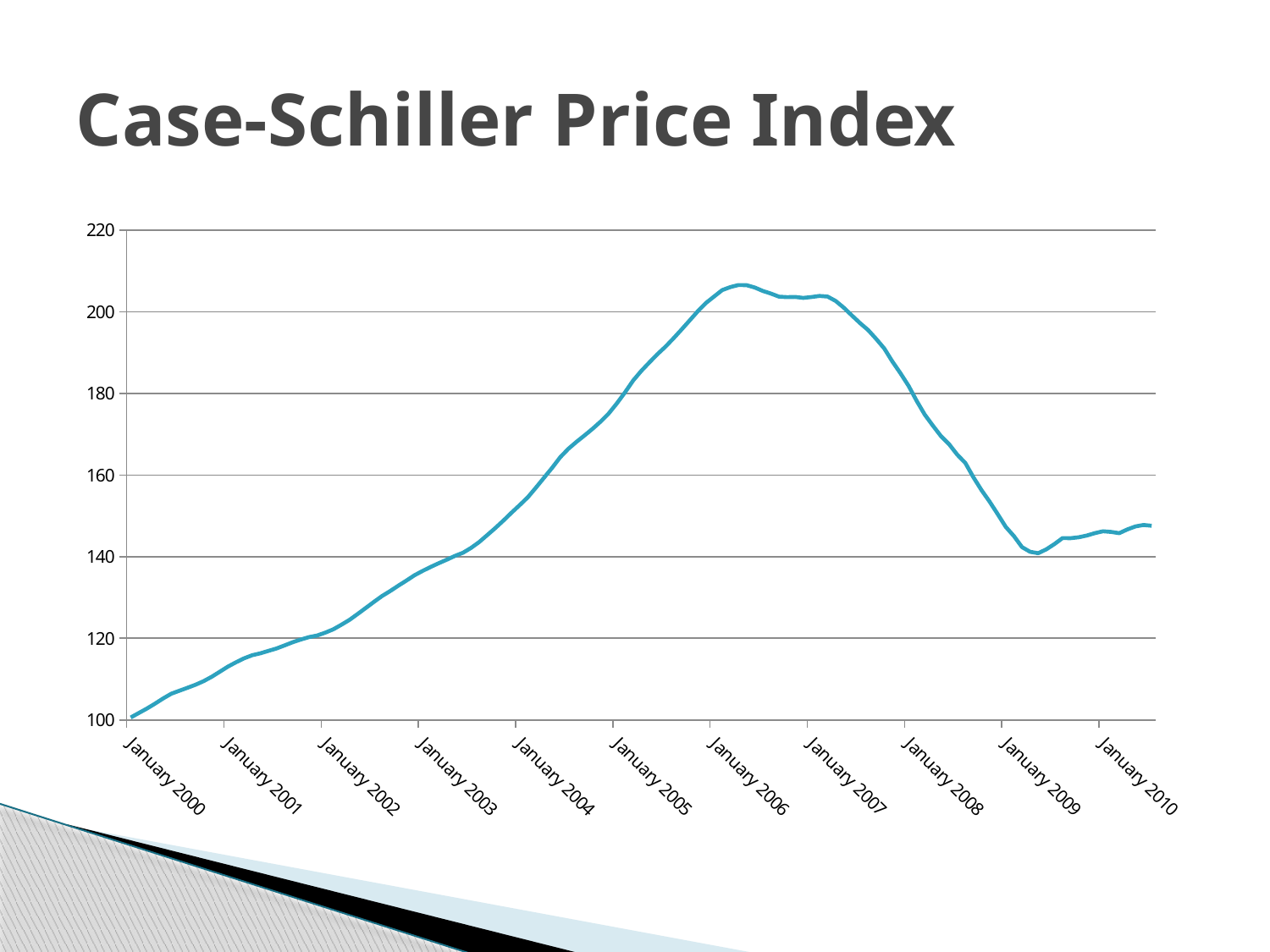
Is the value for January 2001 greater or less than 120? less Is the value for January 2006 greater or less than 200? greater What is the title of the slide's chart? Case-Schiller Price Index Which labelled January has the lowest value on the chart? January 2000 What kind of chart is shown on the slide? line chart Which is larger, the value at January 2005 or the value at January 2009? January 2005 Is the value for January 2004 greater or less than 160? less Does the index rise or fall between January 2000 and January 2006? rise Does the index rise or fall between January 2007 and January 2009? fall How many January labels are shown on the x axis? 11